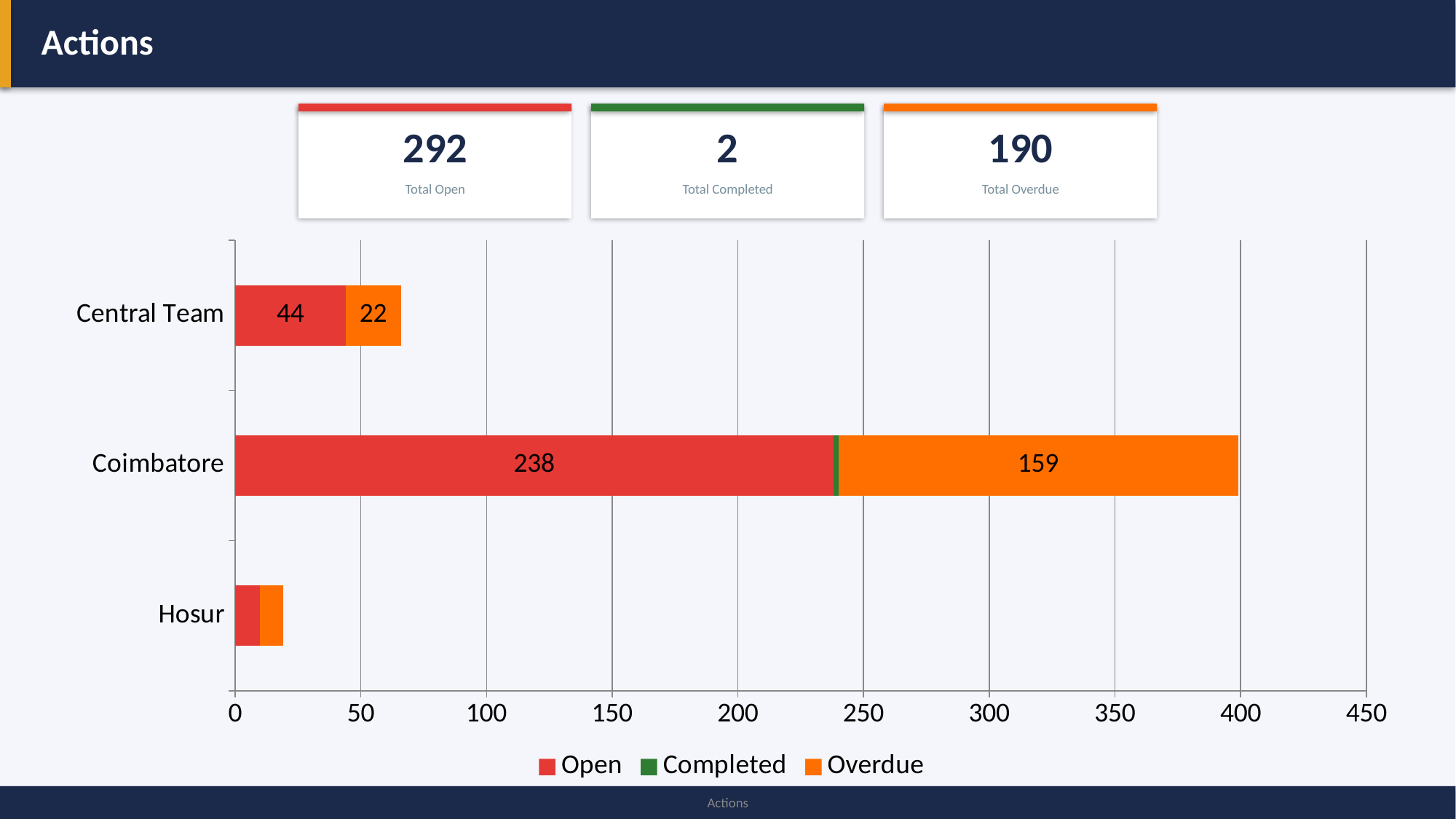
How many series does the legend list? 3 Is the Open value for Hosur greater or less than 50? less What is the Overdue value for Coimbatore? 159 Which category has the highest Open value? Coimbatore How many categories are shown on the chart? 3 What is the Open value for Central Team? 44 What is the Overdue value for Central Team? 22 Which category has the lowest Overdue value? Hosur What is the difference between the Overdue values for Coimbatore and Central Team? 137 What is the Open value for Coimbatore? 238 What is the difference between the Open values for Coimbatore and Central Team? 194 For Central Team, which is larger: the Open value or the Overdue value? Open